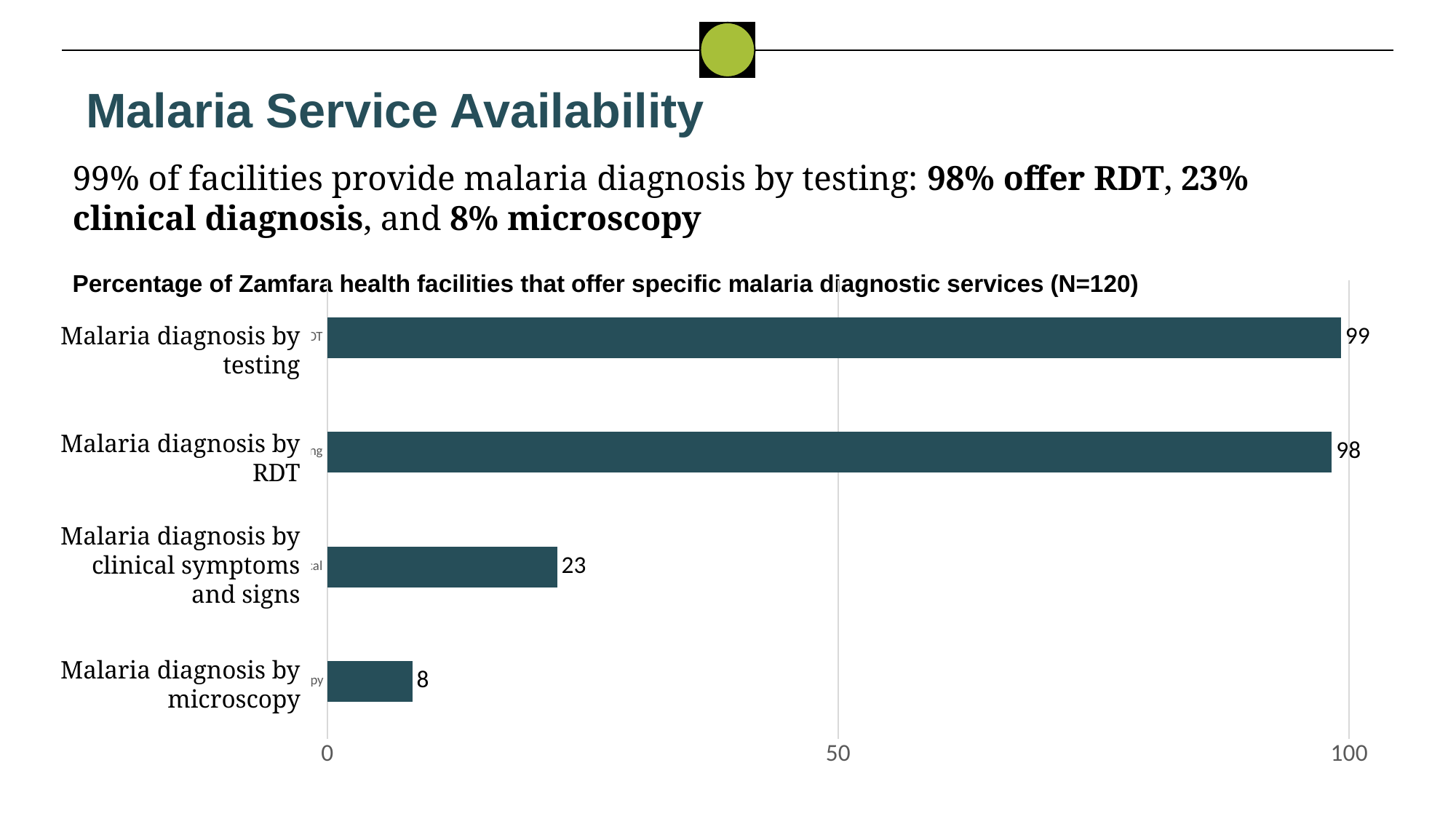
What is the value for Malaria diagnosis by clinical symptoms and signs? 23 What is the value for Malaria diagnosis by microscopy? 8 What is the difference between the values for Malaria diagnosis by clinical symptoms and signs and Malaria diagnosis by microscopy? 15 What kind of chart is shown on the slide? bar chart Which category has the highest value? Malaria diagnosis by testing Which is larger: the value for Malaria diagnosis by RDT or the value for Malaria diagnosis by microscopy? Malaria diagnosis by RDT Which category has the lowest value? Malaria diagnosis by microscopy What is the value for Malaria diagnosis by RDT? 98 Is the value for Malaria diagnosis by clinical symptoms and signs greater or less than 50? less How many categories are shown in the chart? 4 What is the value for Malaria diagnosis by testing? 99 What is the difference between the values for Malaria diagnosis by RDT and Malaria diagnosis by clinical symptoms and signs? 75